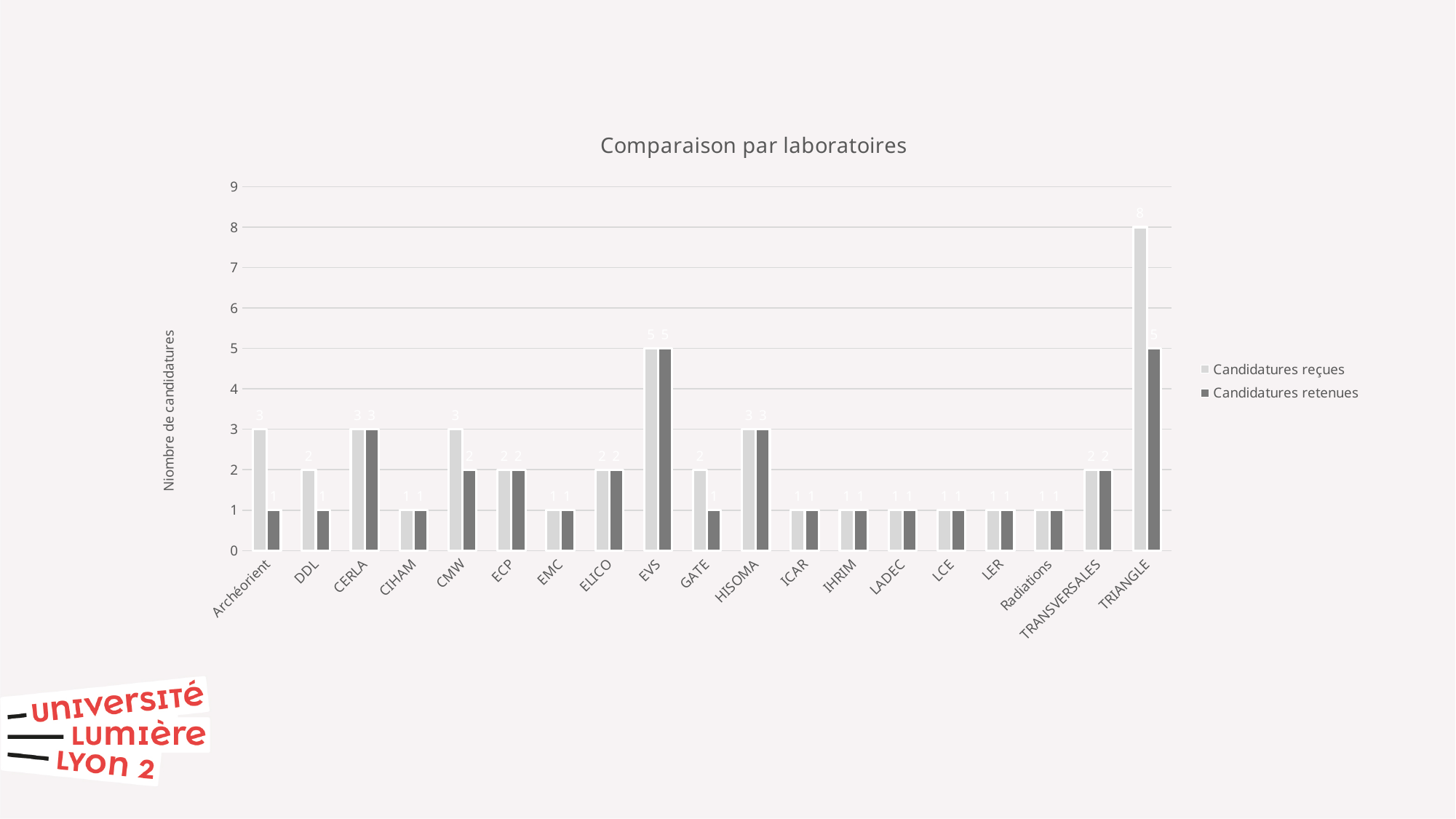
What is the value of Candidatures reçues for TRIANGLE? 8 What kind of chart is shown on the slide? bar chart Which is larger for GATE: Candidatures reçues or Candidatures retenues? Candidatures reçues How many series does the legend list? 2 What is the label of the vertical axis? Niombre de candidatures What is the title of the chart? Comparaison par laboratoires How many laboratories (categories) are shown on the x axis? 19 What is the difference between Candidatures reçues and Candidatures retenues for Archéorient? 2 What is the value of Candidatures retenues for CMW? 2 What is the value of Candidatures reçues for EVS? 5 What is the value of Candidatures retenues for TRIANGLE? 5 Which laboratory has the highest number of Candidatures reçues? TRIANGLE